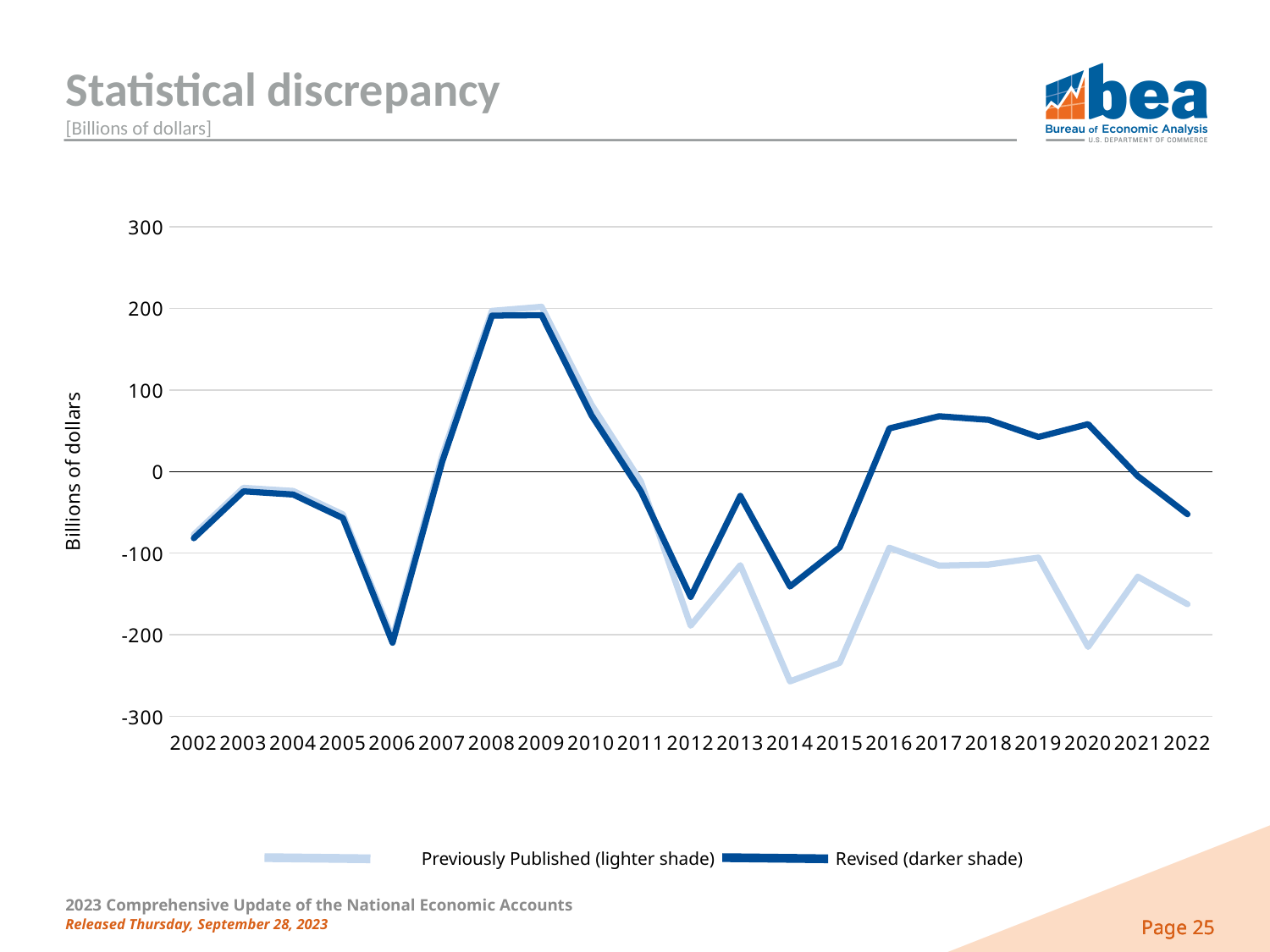
What kind of chart is shown on the slide? Line chart How many years are plotted along the x axis? 21 Which series is drawn in the darker shade according to the legend? Revised Is the Revised value for 2012 greater or less than -100? less How many series does the legend list? 2 Is the Revised value for 2017 greater or less than 0? greater In which year is the Revised series at its lowest? 2006 In which year is the Previously Published series at its lowest? 2014 Is the Previously Published value for 2014 greater or less than -200? less What is the title of the chart? Statistical discrepancy For 2016, which series has the larger value, Previously Published or Revised? Revised